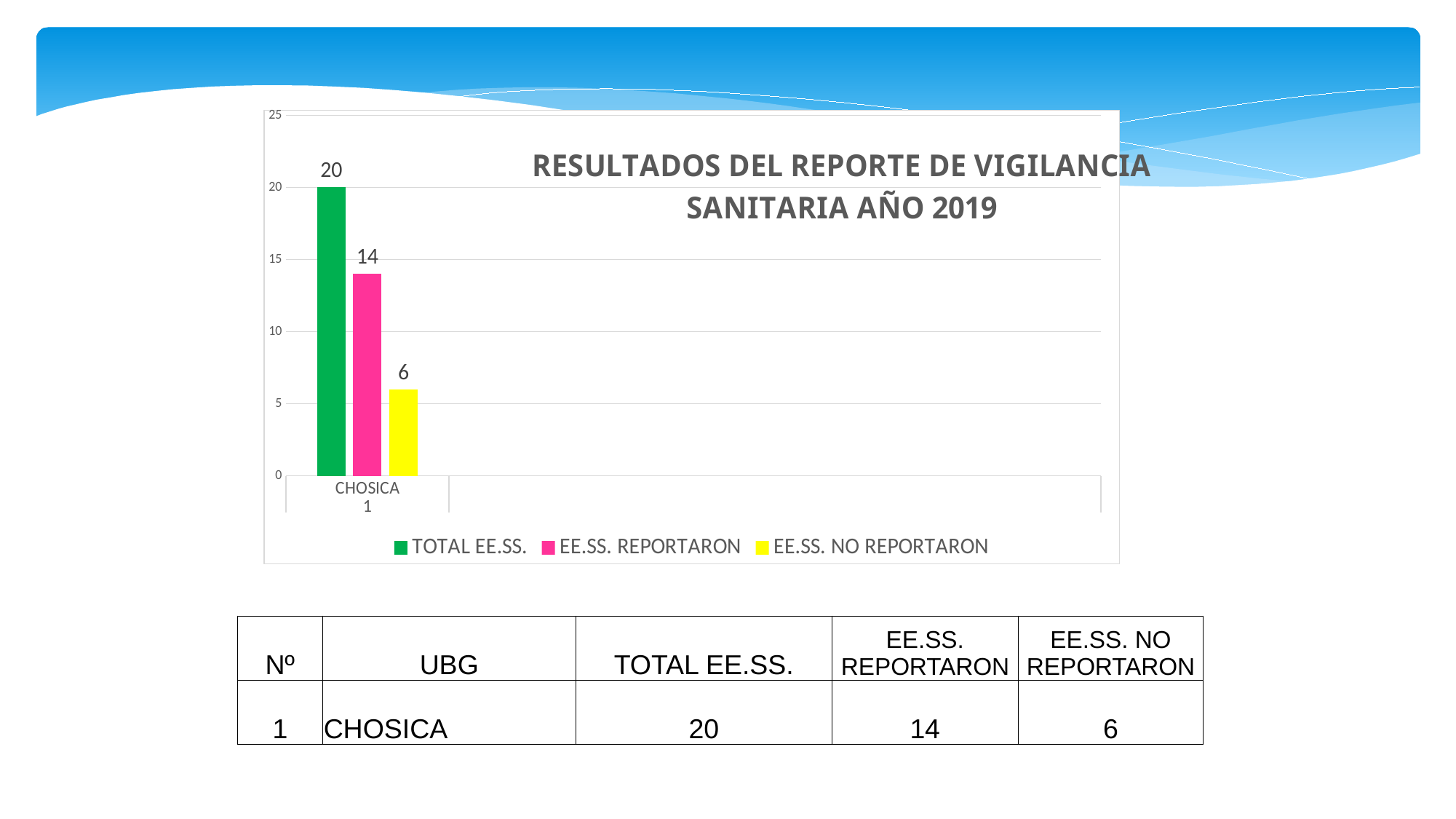
How many series does the legend list? 3 Which series has the highest value for CHOSICA? TOTAL EE.SS. Which series has the lowest value for CHOSICA? EE.SS. NO REPORTARON What is the difference between TOTAL EE.SS. and EE.SS. REPORTARON for CHOSICA? 6 What is the value of TOTAL EE.SS. for CHOSICA? 20 What is the value of EE.SS. NO REPORTARON for CHOSICA? 6 What is the value of EE.SS. REPORTARON for CHOSICA? 14 Is the value of EE.SS. REPORTARON for CHOSICA greater or less than 10? greater Which is larger for CHOSICA: EE.SS. REPORTARON or EE.SS. NO REPORTARON? EE.SS. REPORTARON What is the difference between EE.SS. REPORTARON and EE.SS. NO REPORTARON for CHOSICA? 8 What kind of chart is shown on the slide? bar chart What is the title of the chart? RESULTADOS DEL REPORTE DE VIGILANCIA SANITARIA AÑO 2019